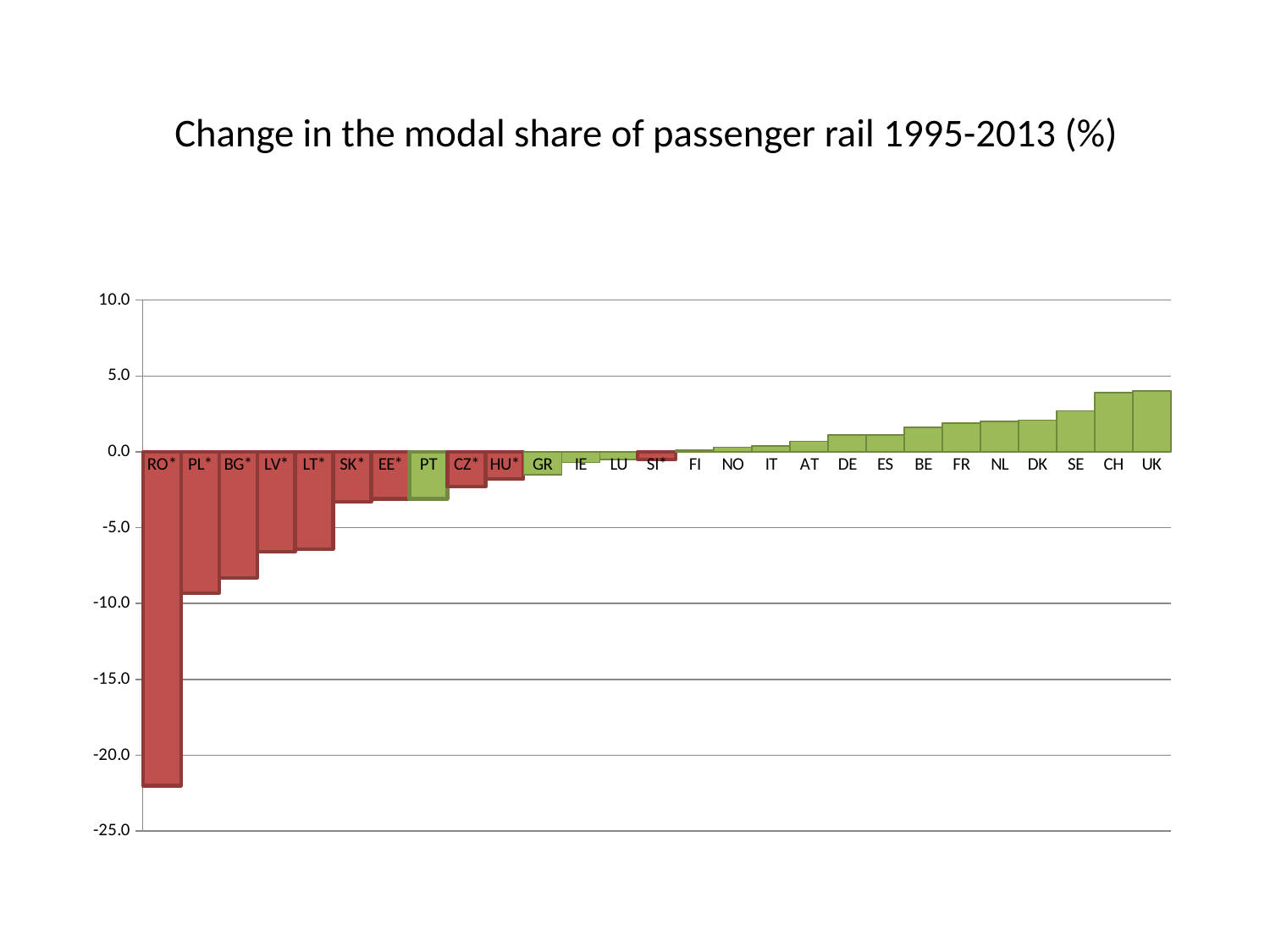
What kind of chart is shown on the slide? bar chart Which has the larger value, LV* or DE? DE Which has the larger value, PL* or BG*? BG* Is the value for SE greater or less than 0.0? greater Is the value for RO* greater or less than -20.0? less Which country has the lowest value in the chart? RO* Is the value for SK* greater or less than -5.0? greater Do the values generally rise or fall moving from left to right along the x axis? rise How many countries are shown on the x axis of the chart? 27 What is the title of the chart? Change in the modal share of passenger rail 1995-2013 (%)